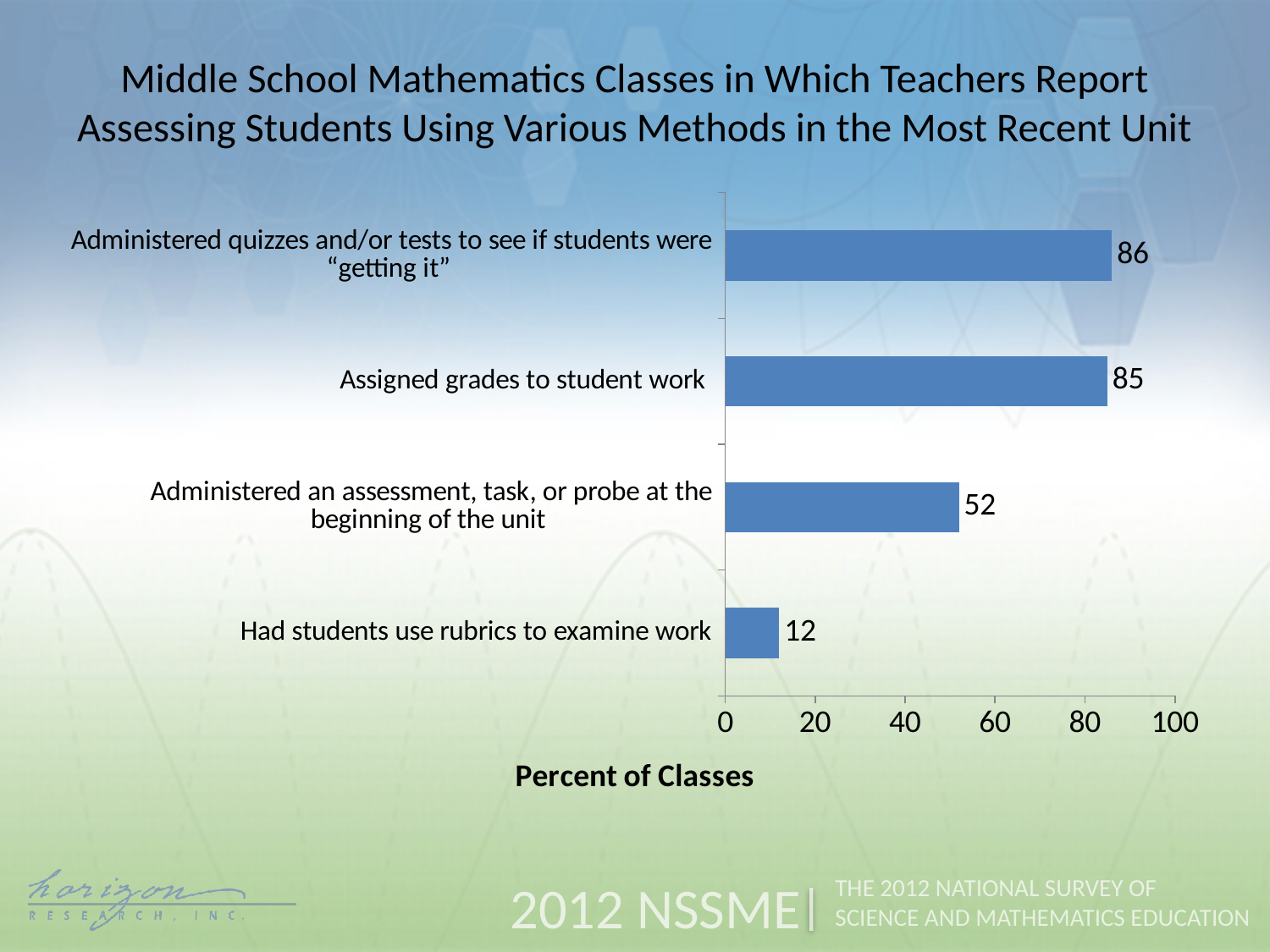
How many assessment methods are shown in the chart? 4 Is the value for "Administered an assessment, task, or probe at the beginning of the unit" greater or less than 60? less Which is larger: the value for assigning grades to student work or the value for administering an assessment at the beginning of the unit? Assigned grades to student work What percent of classes administered an assessment, task, or probe at the beginning of the unit? 52 What is the value for "Assigned grades to student work"? 85 What is the label of the horizontal axis? Percent of Classes What is the difference between "Assigned grades to student work" and "Administered an assessment, task, or probe at the beginning of the unit"? 33 What percent of classes had students use rubrics to examine work? 12 What kind of chart is shown on the slide? Bar chart Which assessment method has the highest percent of classes? Administered quizzes and/or tests to see if students were "getting it" What is the difference between the value for administering quizzes and/or tests and the value for having students use rubrics? 74 Which assessment method has the lowest percent of classes? Had students use rubrics to examine work